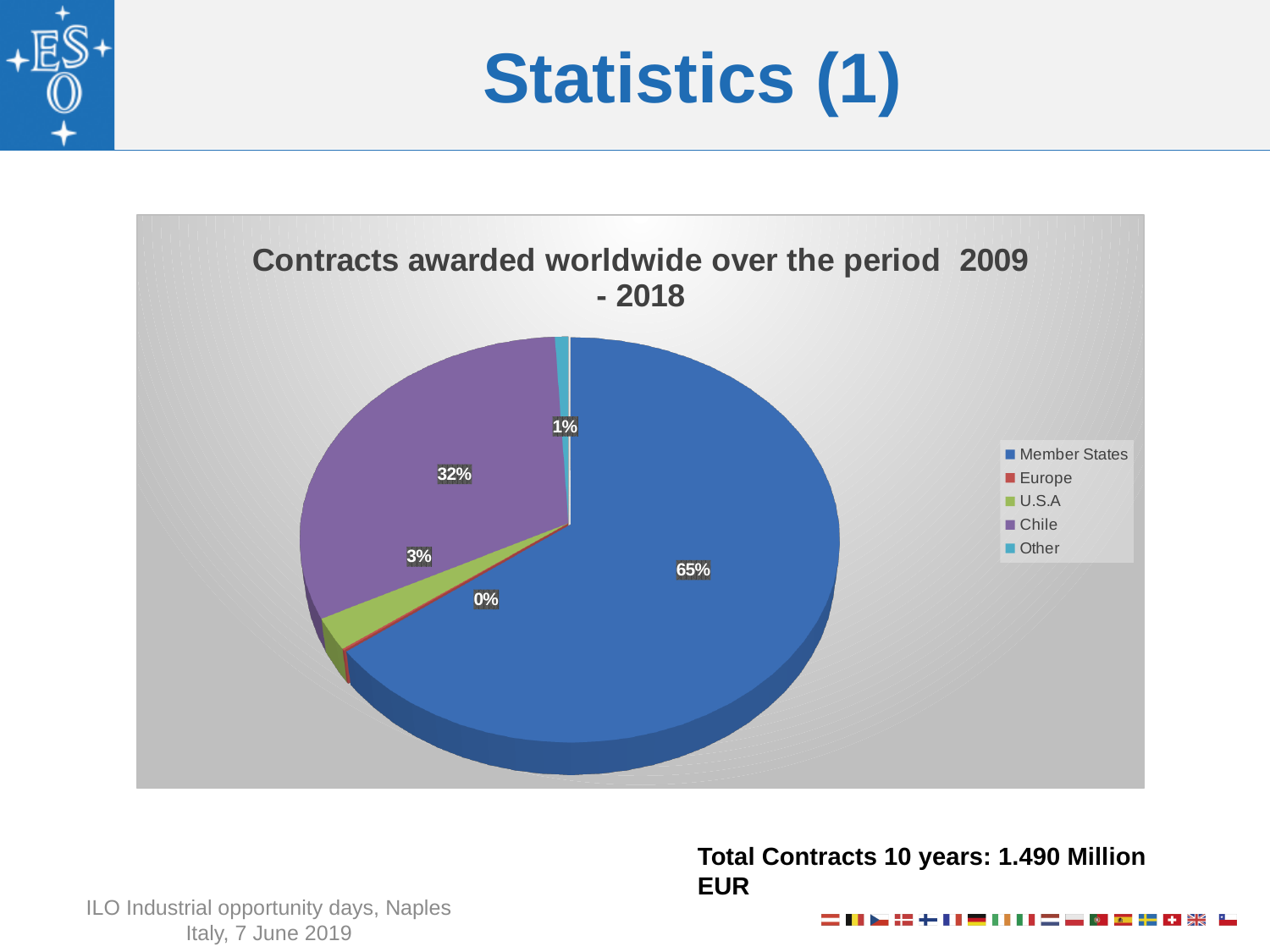
What percentage is shown for the Other slice? 1% What percentage is shown for the Europe slice? 0% What type of chart is shown on the slide? Pie chart Which category has the largest share of contracts awarded? Member States How many categories does the legend list? 5 What is the title of the chart? Contracts awarded worldwide over the period 2009 - 2018 What share of contracts awarded worldwide over 2009-2018 went to Member States? 65% What percentage is shown for the U.S.A slice? 3% What share of the pie does Chile represent? 32% Which has a larger share, Chile or U.S.A? Chile What is the difference in percentage points between the Member States share and the Chile share? 33 Which category has the smallest share of contracts awarded? Europe